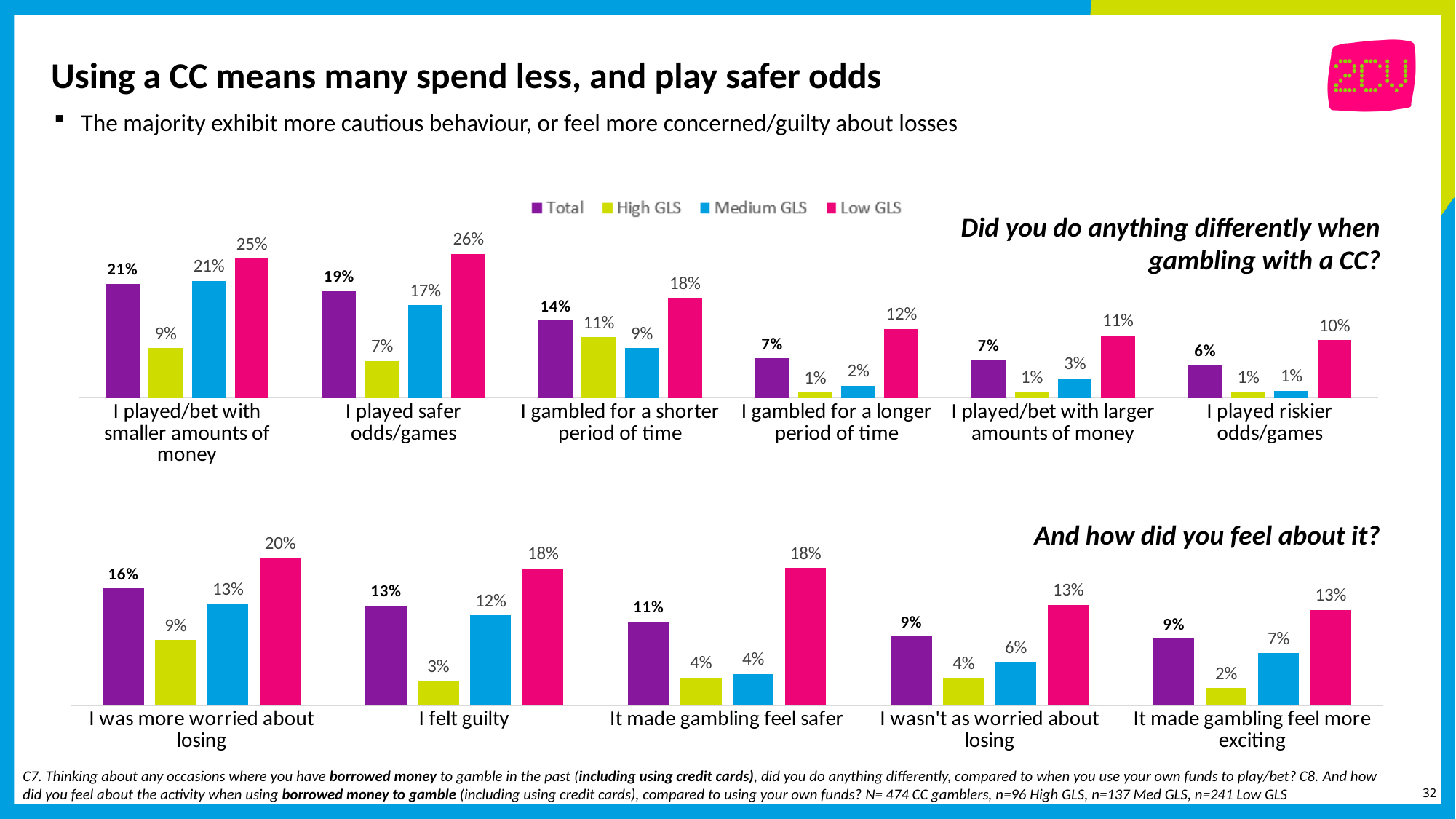
In the bottom chart, what is the difference between the Low GLS and Medium GLS values for "I felt guilty"? 6% In the bottom chart ("And how did you feel about it?"), what is the Total value for "I was more worried about losing"? 16% How many series does the legend list? 4 In the top chart, what is the difference between the Low GLS and High GLS values for "I gambled for a shorter period of time"? 7% In the top chart ("Did you do anything differently when gambling with a CC?"), what is the Total value for "I played/bet with smaller amounts of money"? 21% In the top chart, which category has the highest Total value? I played/bet with smaller amounts of money In the top chart, what is the Low GLS value for "I played safer odds/games"? 26% In the bottom chart, which category has the lowest High GLS value? It made gambling feel more exciting How many categories are shown in the top chart? 6 In the top chart, for "I gambled for a longer period of time", which is larger: the Medium GLS value or the Low GLS value? Low GLS In the bottom chart, do the Total values rise or fall from left to right across the categories? Fall What type of chart is the bottom chart? Bar chart